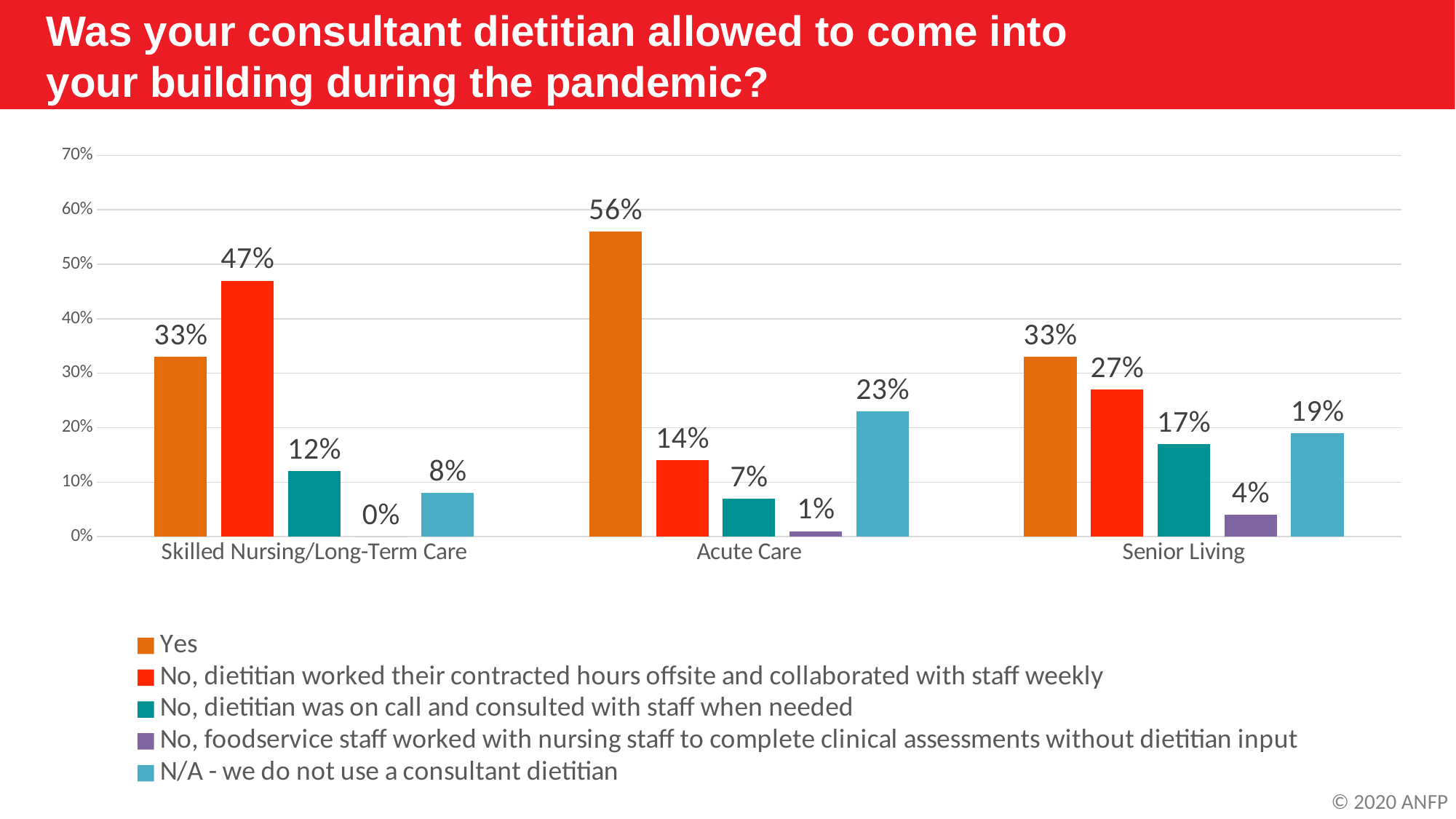
Which category has the highest "Yes" value? Acute Care How many categories are shown on the x axis? 3 Which is larger in Skilled Nursing/Long-Term Care: "Yes" or "No, dietitian worked their contracted hours offsite and collaborated with staff weekly"? No, dietitian worked their contracted hours offsite and collaborated with staff weekly What is the value for "No, dietitian worked their contracted hours offsite and collaborated with staff weekly" in Skilled Nursing/Long-Term Care? 47% What is the difference between the "Yes" value for Acute Care and the "Yes" value for Senior Living? 23% Which category has the lowest value for "No, foodservice staff worked with nursing staff to complete clinical assessments without dietitian input"? Skilled Nursing/Long-Term Care How many series does the legend list? 5 What percentage of Acute Care respondents answered "Yes"? 56% What kind of chart is shown on the slide? Bar chart What is the value for "N/A - we do not use a consultant dietitian" in Senior Living? 19% What colour represents the "Yes" series? Orange Is the "N/A - we do not use a consultant dietitian" value for Acute Care greater or less than 20%? greater